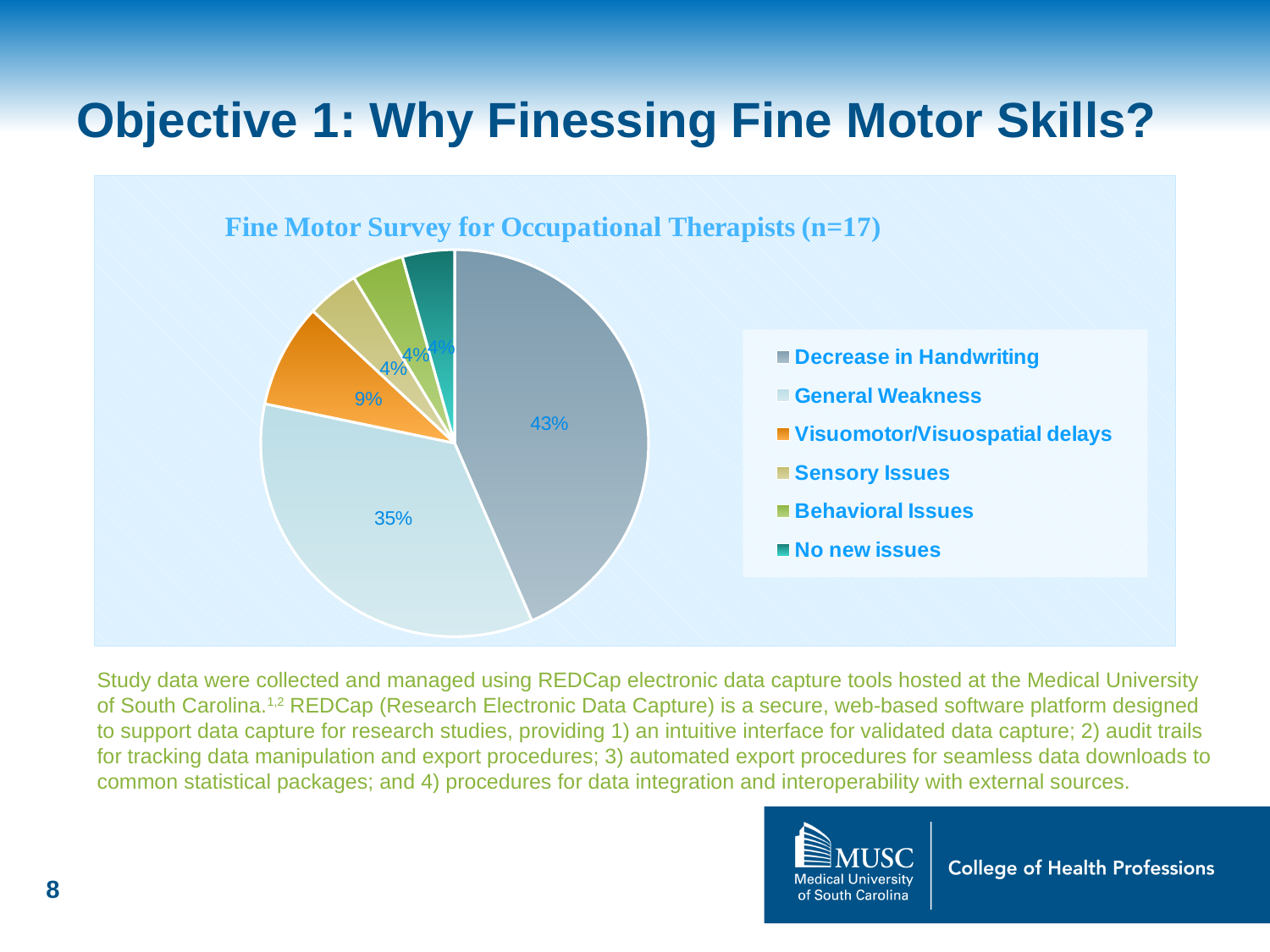
What is the title of the chart? Fine Motor Survey for Occupational Therapists (n=17) Which category has the largest share of the pie? Decrease in Handwriting How many categories does the legend list? 6 What is the sample size shown in the chart title? n=17 What percentage of the pie is Decrease in Handwriting? 43% What percentage of the pie is Visuomotor/Visuospatial delays? 9% What type of chart is shown on the slide? Pie chart Which is larger, the share for General Weakness or the share for Visuomotor/Visuospatial delays? General Weakness What percentage of the pie is Sensory Issues? 4% What percentage of the pie is General Weakness? 35% What is the difference in percentage points between Decrease in Handwriting and General Weakness? 8 What is the combined share of Decrease in Handwriting and General Weakness? 78%